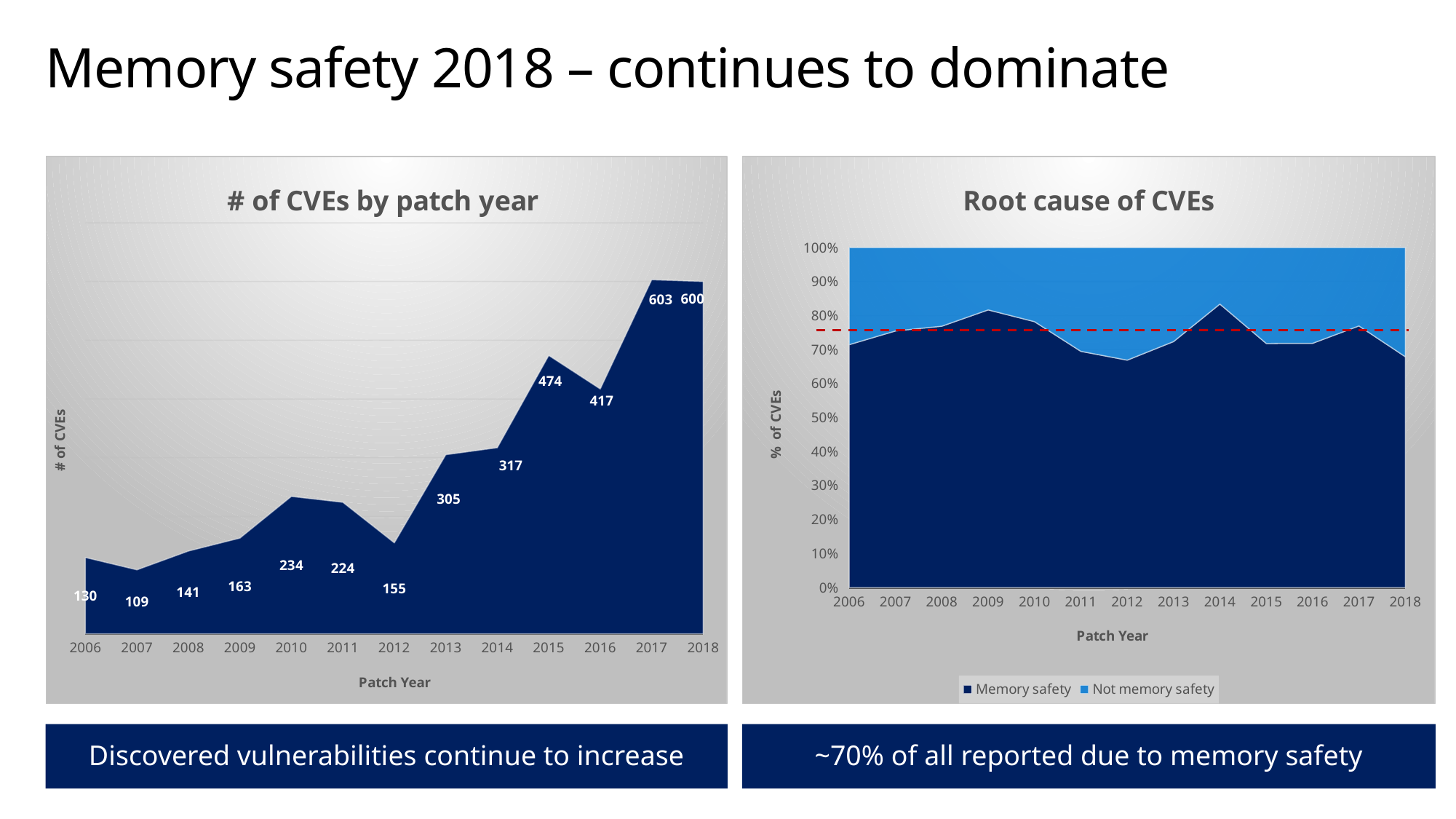
In the '# of CVEs by patch year' chart, what is the value for 2012? 155 In the 'Root cause of CVEs' chart, what is the label on the y axis? % of CVEs In the '# of CVEs by patch year' chart, which patch year has the highest number of CVEs? 2017 In the '# of CVEs by patch year' chart, what is the difference between the 2015 and 2016 values? 57 In the 'Root cause of CVEs' chart, is the Memory safety share in 2014 greater or less than 80%? greater In the '# of CVEs by patch year' chart, how many CVEs were there in 2017? 603 In the '# of CVEs by patch year' chart, which patch year has the lowest number of CVEs? 2007 In the '# of CVEs by patch year' chart, how many patch years are plotted? 13 In the 'Root cause of CVEs' chart, how many series does the legend list? 2 In the 'Root cause of CVEs' chart, is the Memory safety share in 2012 greater or less than 70%? less In the '# of CVEs by patch year' chart, which year has more CVEs, 2010 or 2011? 2010 In the '# of CVEs by patch year' chart, what is the overall trend in the number of CVEs from 2006 to 2018? Rising